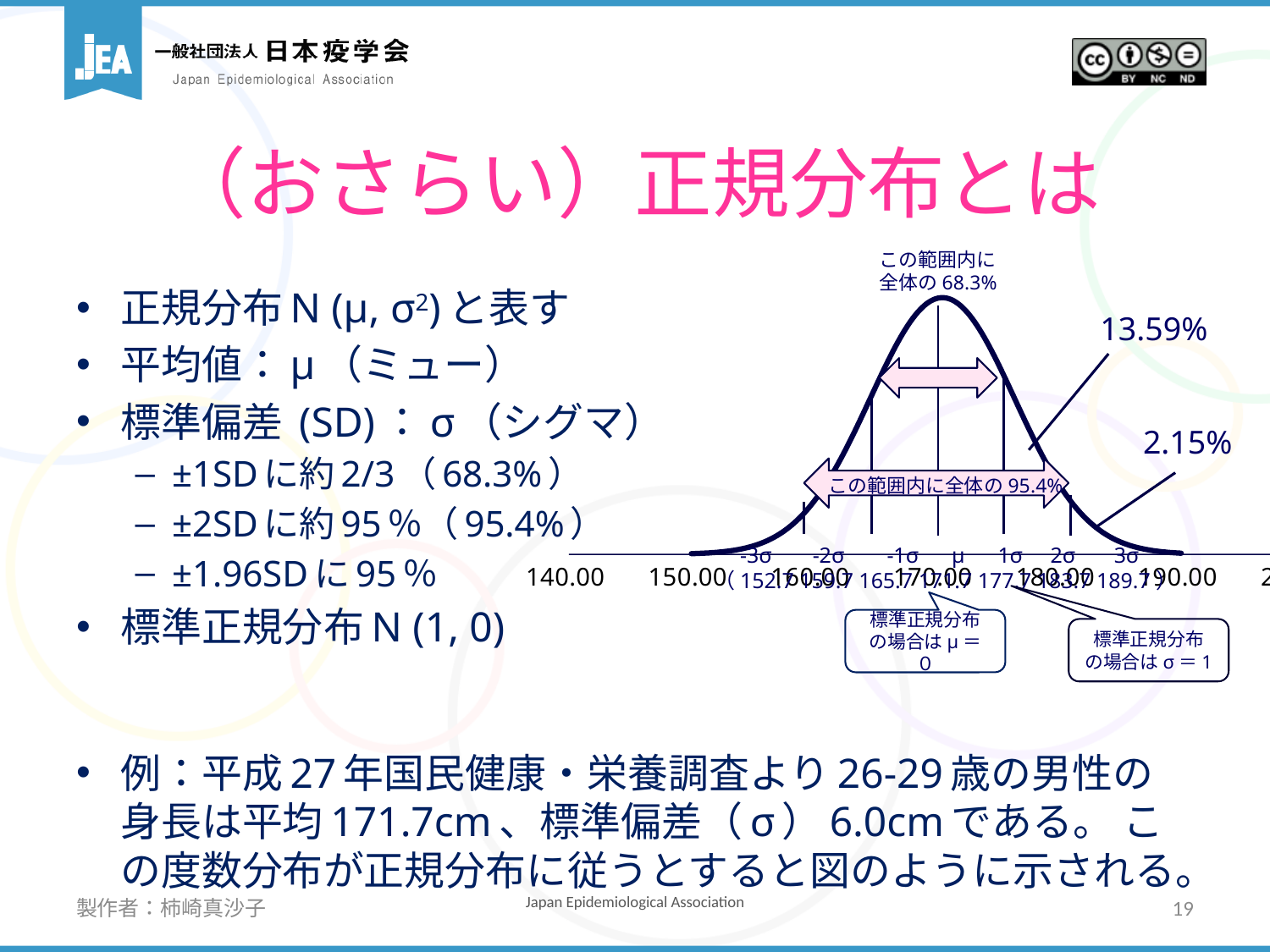
What percentage is labeled for the region between 1σ and 2σ on the chart? 13.59% At which labeled position on the x axis does the curve reach its highest point? μ What height value is printed at the 3σ position on the chart? 189.7 According to the text box on the chart, what is μ in the case of the standard normal distribution? 0 What is the lowest value labeled on the x axis of the chart? 140.00 Is the curve higher at μ or at 2σ? μ What kind of chart is shown on the slide? line chart According to the annotation on the chart, what percentage of the whole lies within the ±1σ range? 68.3% What percentage is labeled for the region between 2σ and 3σ on the chart? 2.15% How many sigma positions (from -3σ to 3σ) are labeled along the x axis? 7 According to the annotation on the chart, what percentage of the whole lies within the ±2σ range? 95.4% Does the curve rise or fall as the x axis goes from 140.00 to 170.00? rise